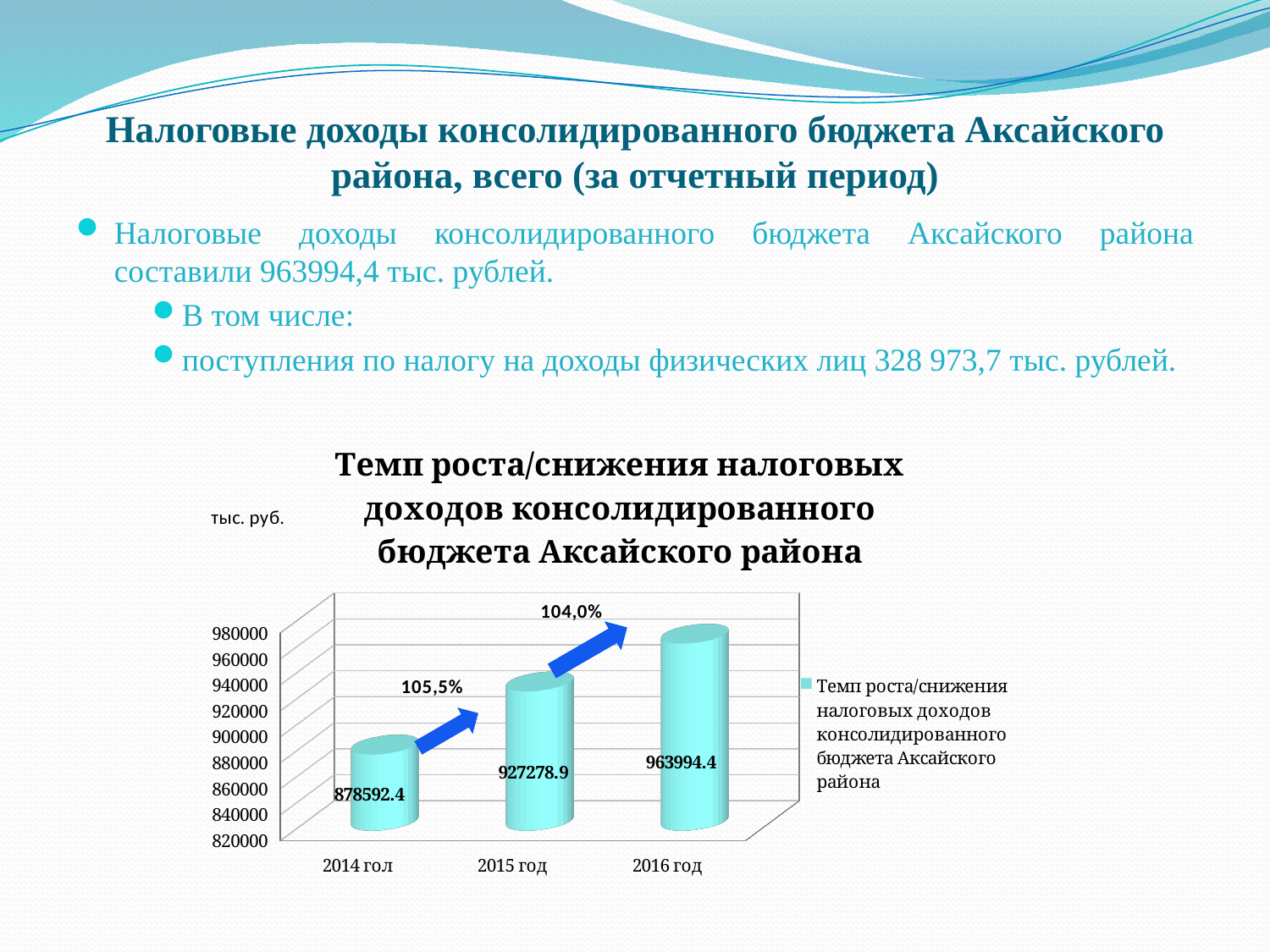
Do the values rise or fall from 2014 год to 2016 год? rise What is the value for 2016 год? 963994.4 What is the value for 2015 год? 927278.9 What is the difference between the values for 2016 год and 2015 год? 36715.5 What kind of chart is shown? bar chart How many years are shown on the x axis? 3 Which year has the highest value? 2016 год Which is larger, the value for 2015 год or the value for 2014 год? 2015 год What is the value for 2014 год? 878592.4 Is the value for 2016 год greater or less than 940000? greater What is the difference between the values for 2015 год and 2014 год? 48686.5 Which year has the lowest value? 2014 год